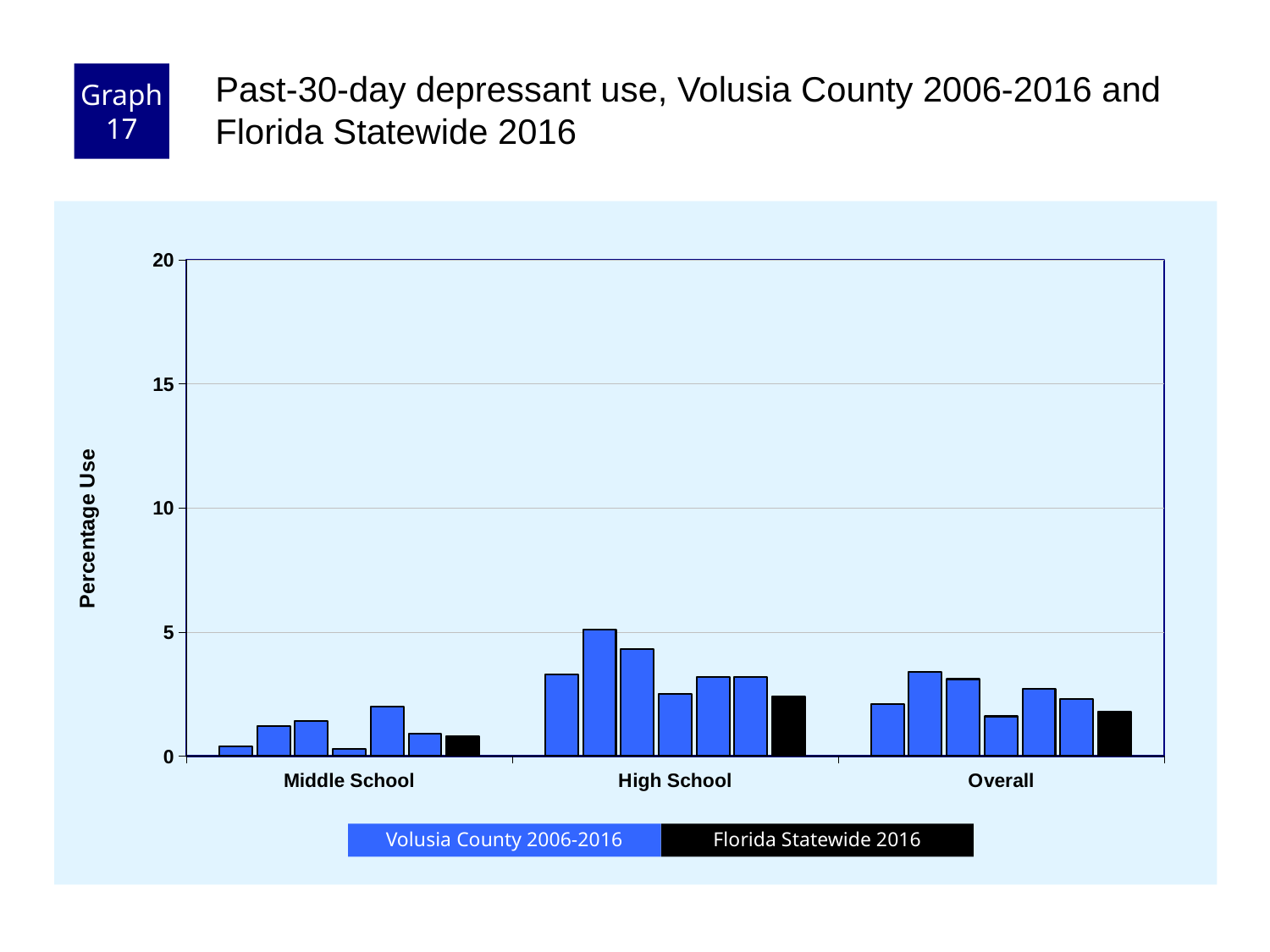
Are all the Middle School bars greater or less than 5? less What kind of chart is shown on the slide? bar chart What is the label on the y axis? Percentage Use What is the title of the chart? Past-30-day depressant use, Volusia County 2006-2016 and Florida Statewide 2016 Which category contains the tallest bar on the chart? High School Is the Florida Statewide 2016 value for High School greater or less than 5? less How many categories are shown on the x axis? 3 Which category contains the shortest bar on the chart? Middle School How many series does the legend list? 2 Is the Florida Statewide 2016 value for Overall greater or less than 5? less Which is larger, the Florida Statewide 2016 value for High School or for Middle School? High School